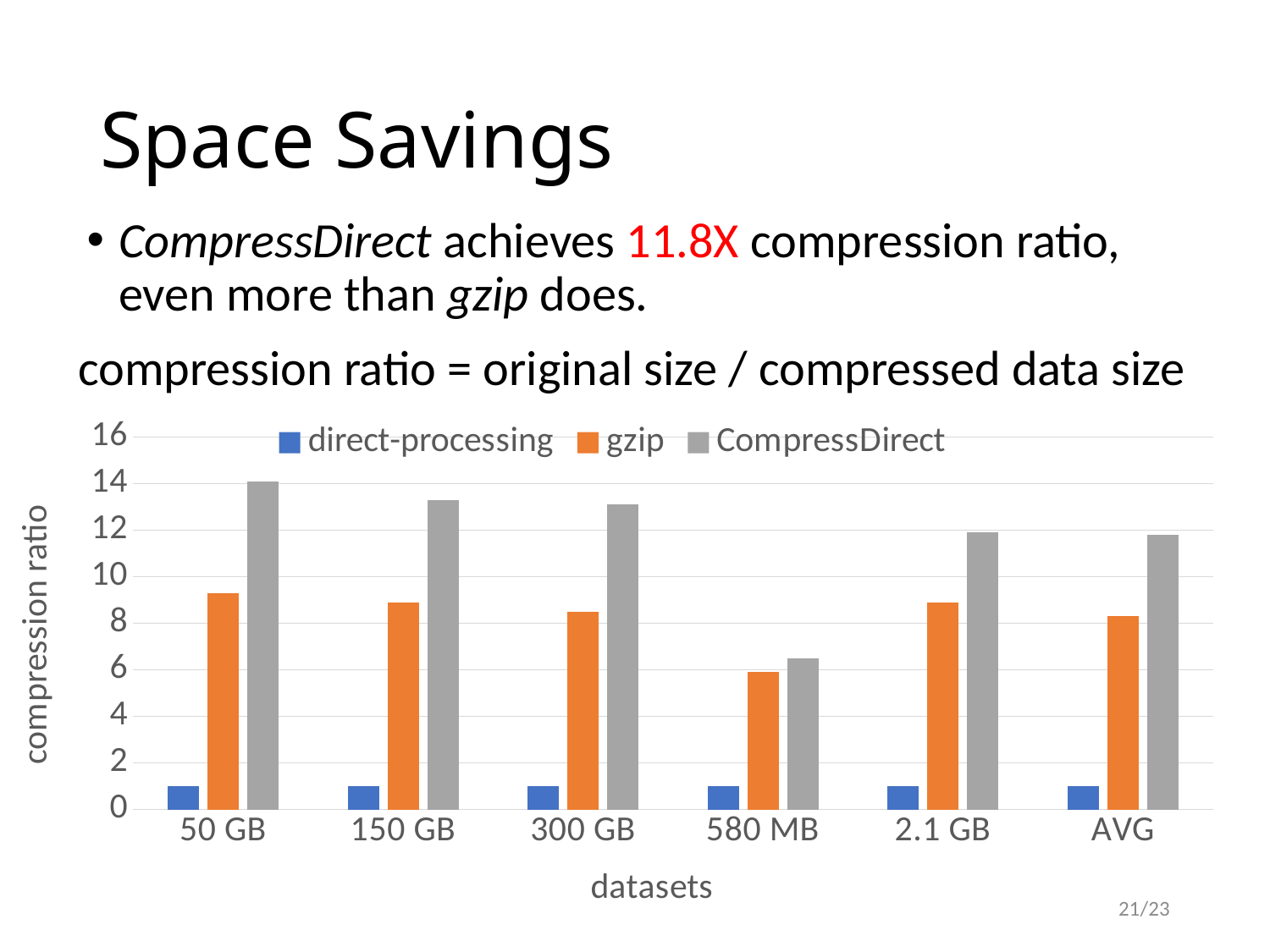
How many series does the legend list? 3 Is the gzip value for 580 MB greater or less than 4? greater For which dataset is the CompressDirect compression ratio highest? 50 GB What is the label on the y axis of the chart? compression ratio Is the gzip value for 50 GB greater or less than 8? greater For which dataset is the gzip compression ratio lowest? 580 MB For the 150 GB dataset, which has the larger compression ratio, gzip or CompressDirect? CompressDirect Is the direct-processing value for 300 GB greater or less than 2? less How many dataset categories are shown on the x axis? 6 What kind of chart is shown on the slide? bar chart For which dataset is the CompressDirect compression ratio lowest? 580 MB